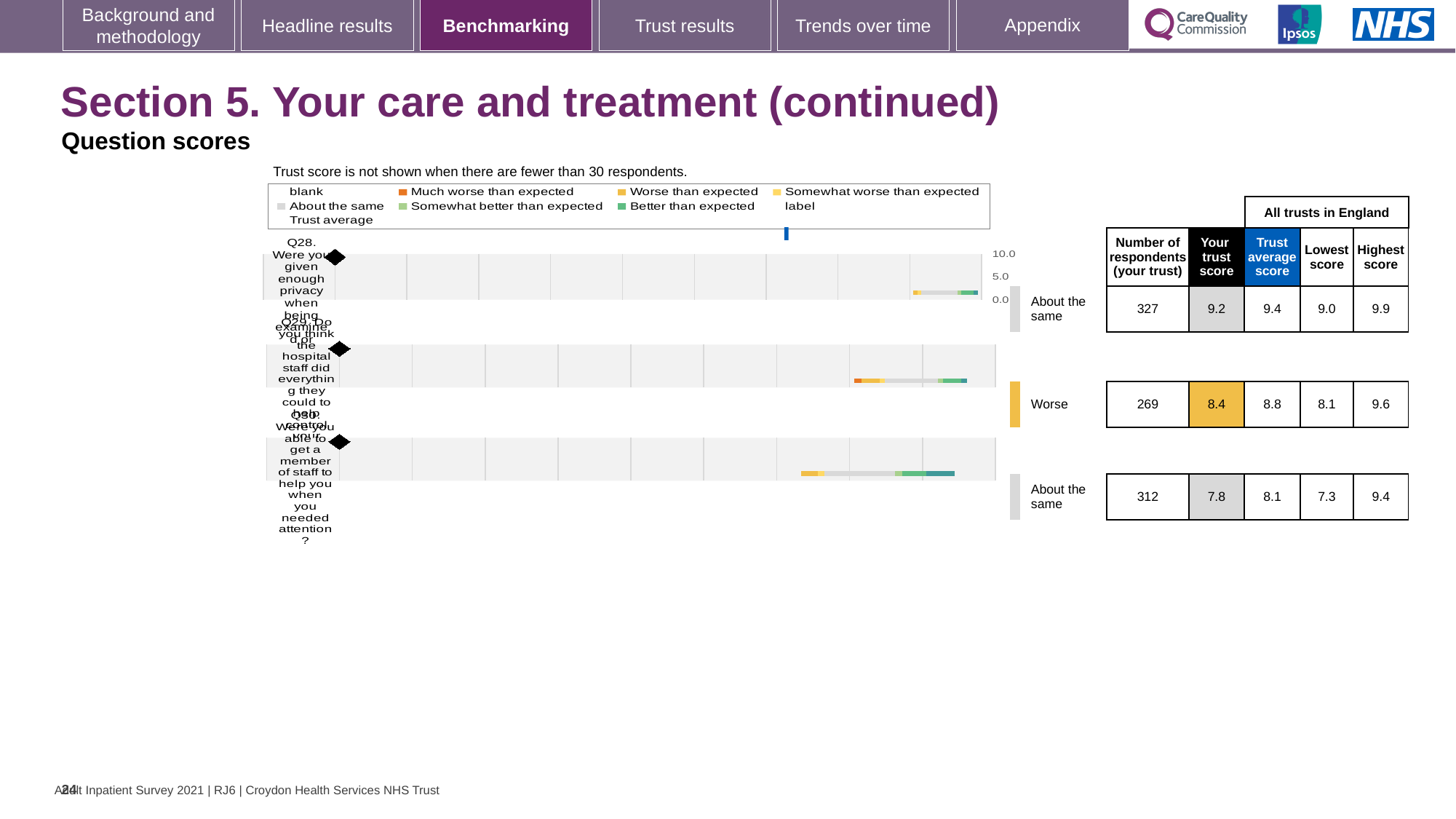
What is the trust score for Q29 (staff did everything to help control your pain)? 8.4 Which of the three questions shown has the lowest trust score? Q30 Is the trust score for Q28 greater or less than 5.0? greater What is the trust score for Q30 (able to get a member of staff to help when you needed attention)? 7.8 What benchmark category is Q29 assigned to? Worse What is the highest score among all trusts in England for Q28? 9.9 How many questions are plotted on the chart? 3 How many respondents answered Q29 at this trust? 269 Which of the three questions shown has the highest trust score? Q28 What is the difference between the trust score and the trust average score for Q29? 0.4 What is the trust average score across all trusts in England for Q30? 8.1 What is the trust score for Q28 (privacy when being examined or treated)? 9.2